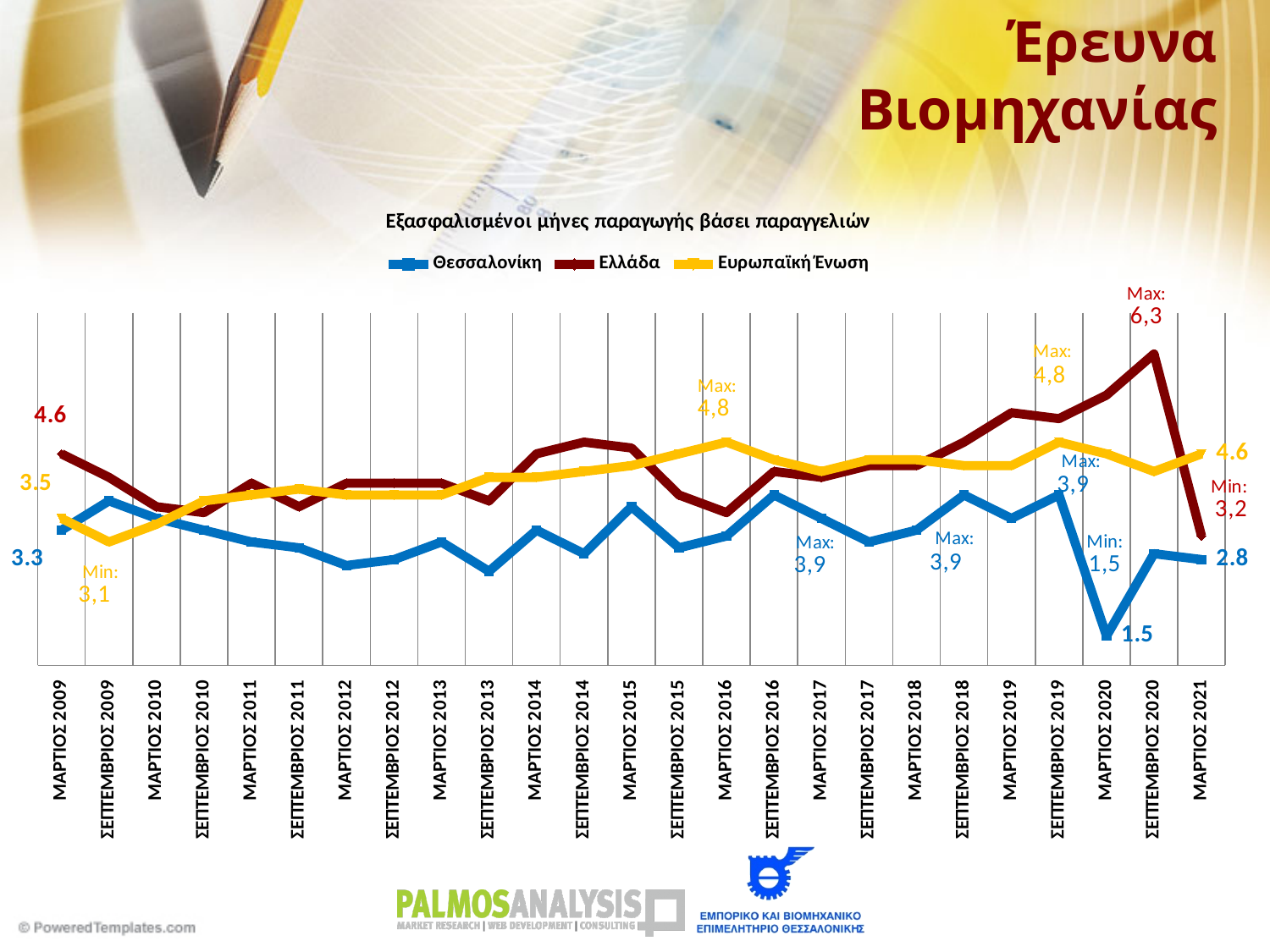
How many time points are plotted along the x axis? 25 What is the title of the chart? Εξασφαλισμένοι μήνες παραγωγής βάσει παραγγελιών What is the maximum value reached by the Ελλάδα series, and in which period? 6,3 in ΣΕΠΤΕΜΒΡΙΟΣ 2020 What is the difference between the Ελλάδα maximum (6,3) and the Ελλάδα minimum (3,2)? 3,1 What is the difference between the Ελλάδα value in ΜΑΡΤΙΟΣ 2009 (4.6) and the Θεσσαλονίκη value in ΜΑΡΤΙΟΣ 2009 (3.3)? 1.3 What is the value for Θεσσαλονίκη in ΜΑΡΤΙΟΣ 2021? 2.8 How many series does the legend list? 3 In ΜΑΡΤΙΟΣ 2021, which series has the higher value: Ευρωπαϊκή Ένωση or Ελλάδα? Ευρωπαϊκή Ένωση What is the minimum value of the Θεσσαλονίκη series, and when does it occur? 1,5 in ΜΑΡΤΙΟΣ 2020 What is the value for Ελλάδα in ΜΑΡΤΙΟΣ 2009? 4.6 What kind of chart is shown on the slide? line chart What is the minimum value of the Ευρωπαϊκή Ένωση series? 3,1